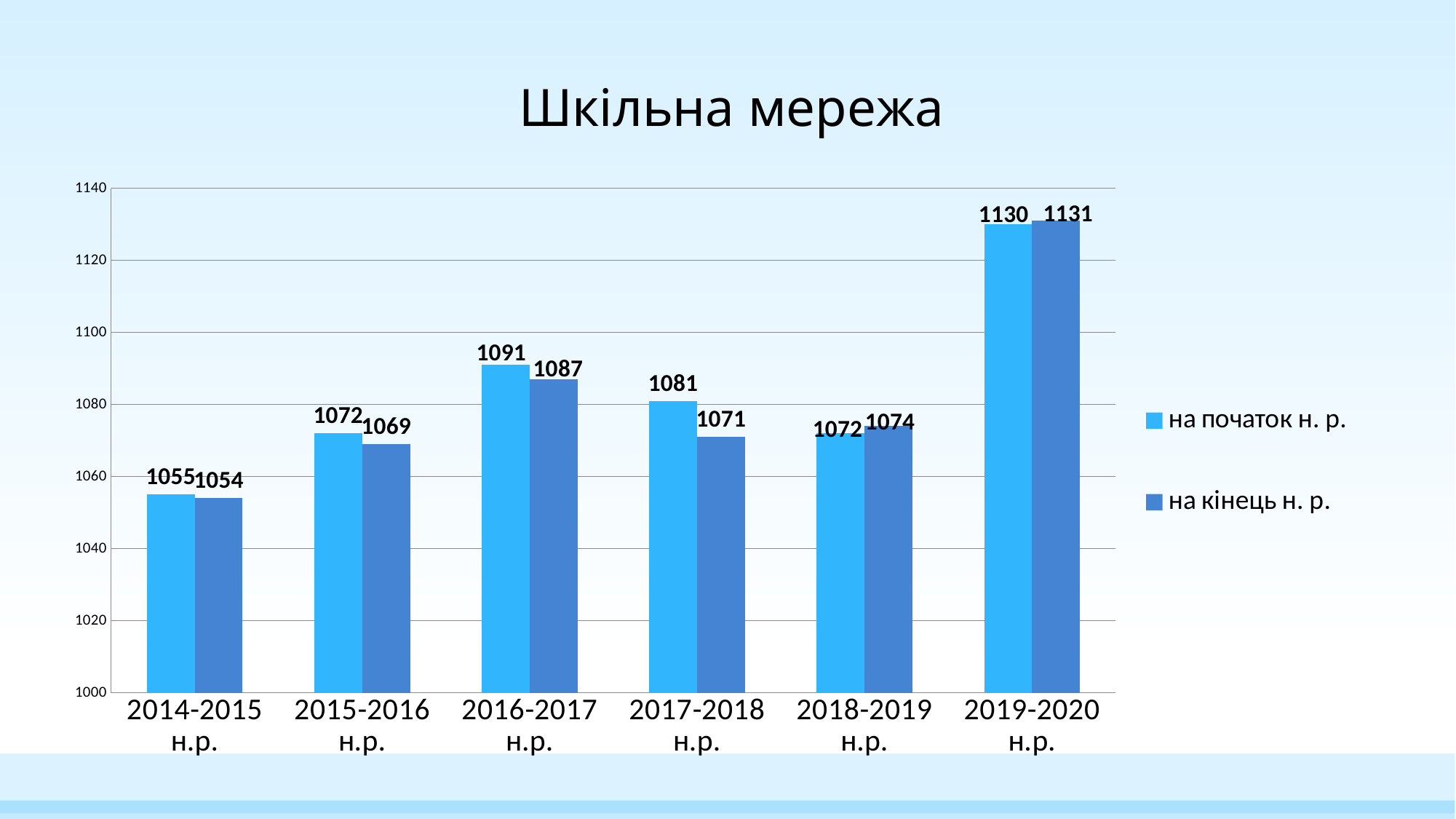
How many school years are shown on the x axis? 6 Which school year has the lowest value for "на кінець н. р."? 2014-2015 н.р. What is the value for "на кінець н. р." in 2019-2020 н.р.? 1131 Is the value for "на початок н. р." in 2019-2020 н.р. greater or less than 1120? greater How many series does the legend list? 2 Which school year has the highest value for "на початок н. р."? 2019-2020 н.р. Which is larger in 2016-2017 н.р.: "на початок н. р." or "на кінець н. р."? на початок н. р. What is the difference between "на початок н. р." and "на кінець н. р." in 2017-2018 н.р.? 10 What is the value for "на початок н. р." in 2014-2015 н.р.? 1055 What is the title of the chart? Шкільна мережа What is the value for "на кінець н. р." in 2017-2018 н.р.? 1071 What kind of chart is shown on the slide? bar chart